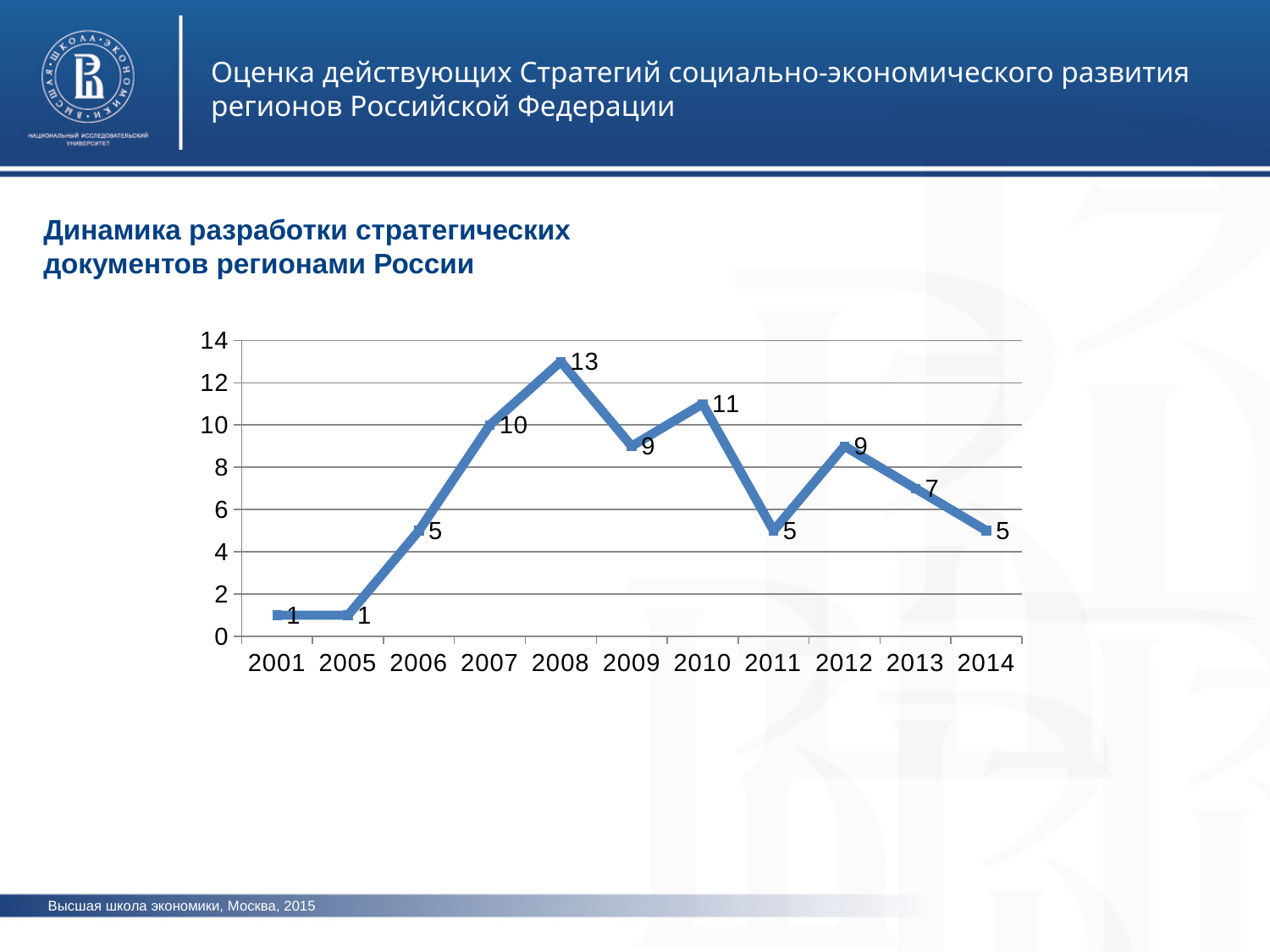
Which is larger, the value for 2007 or the value for 2012? 2007 What is the title of the chart? Динамика разработки стратегических документов регионами России Do the values rise or fall from 2012 to 2014? fall What is the value for 2008? 13 What is the difference between the values for 2008 and 2009? 4 What type of chart is shown on the slide? line chart Which year has the highest value? 2008 What is the difference between the values for 2010 and 2011? 6 How many years are plotted on the x axis? 11 What is the value for 2013? 7 Do the values rise or fall from 2005 to 2008? rise What is the value for 2010? 11